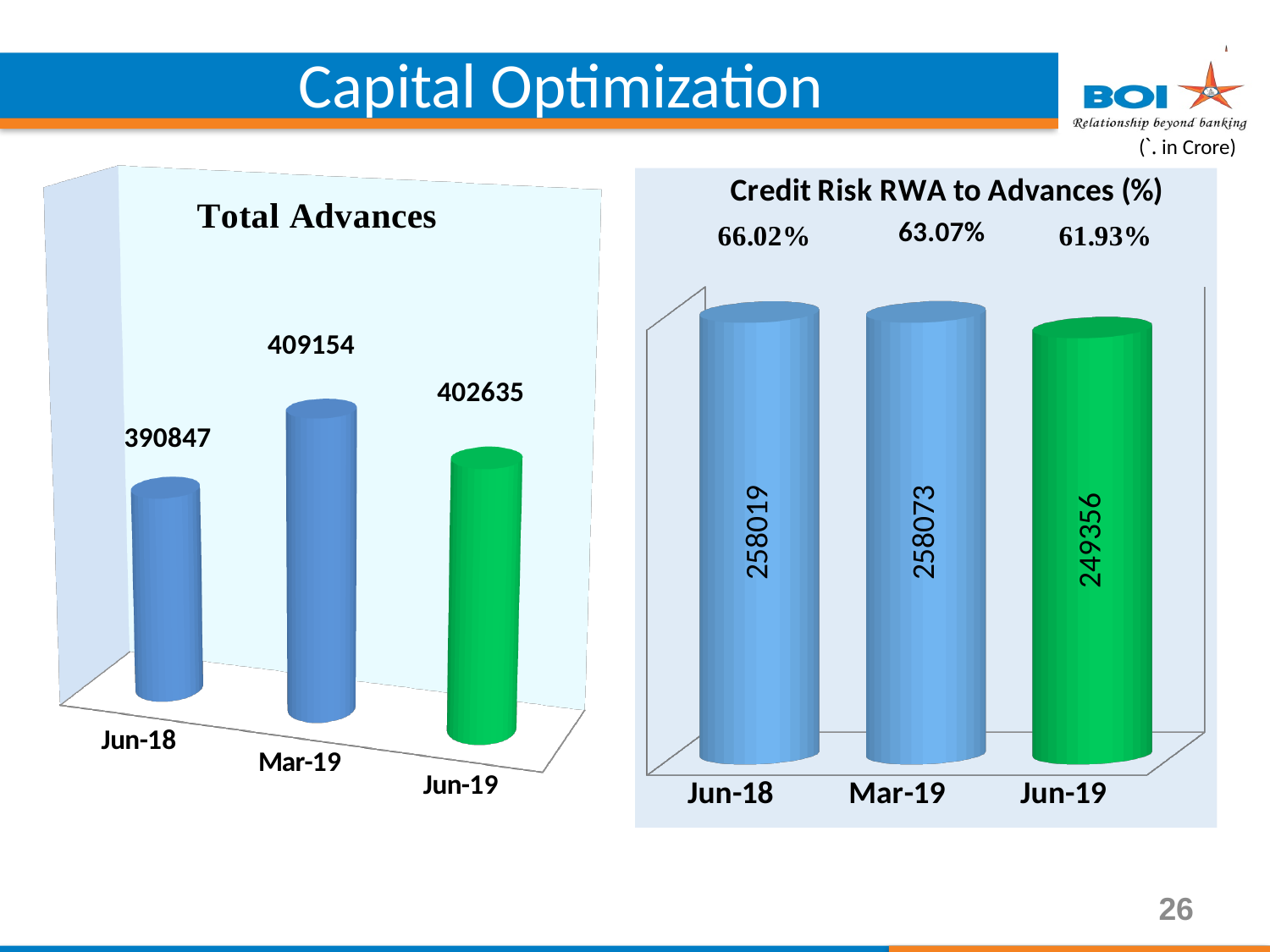
In the Total Advances chart, what is the value for Jun-18? 390847 In the Credit Risk RWA to Advances (%) chart, which period has the lowest bar value? Jun-19 In the Total Advances chart, which period has the lowest value? Jun-18 In the Credit Risk RWA to Advances (%) chart, what is the bar value for Jun-19? 249356 In the Credit Risk RWA to Advances (%) chart, what percentage is shown above the Jun-18 bar? 66.02% In the Credit Risk RWA to Advances (%) chart, what percentage is shown above the Mar-19 bar? 63.07% In the Total Advances chart, what is the difference between the Mar-19 and Jun-19 values? 6519 In the Total Advances chart, what is the value for Mar-19? 409154 How many periods are shown in the Total Advances chart? 3 In the Credit Risk RWA to Advances (%) chart, what is the difference between the Mar-19 and Jun-19 bar values? 8717 What kind of chart is the Total Advances chart? Bar chart In the Total Advances chart, which period has the highest value? Mar-19